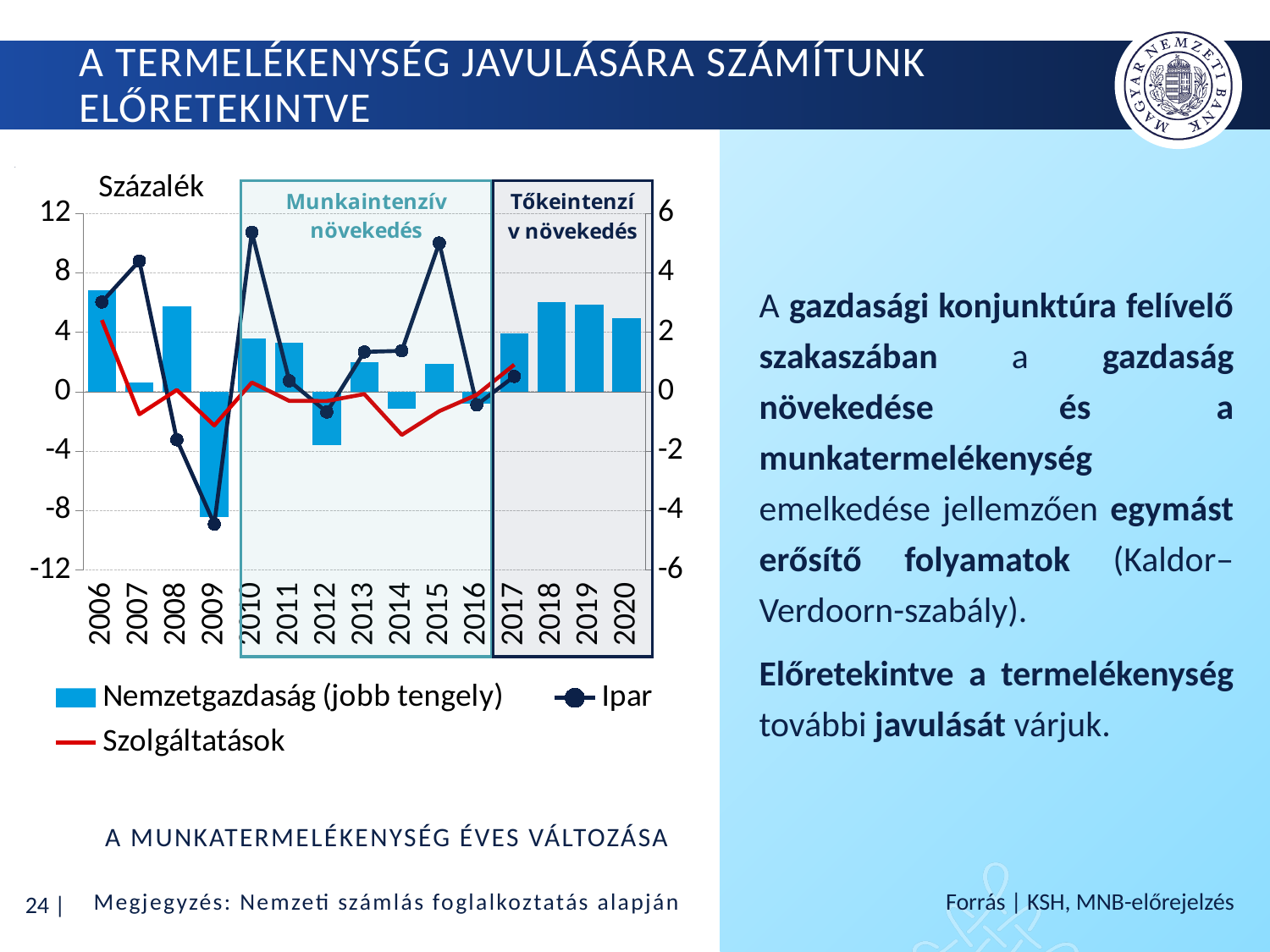
In which year is the Nemzetgazdaság bar lowest? 2009 Which series is plotted on the right axis according to the legend? Nemzetgazdaság How many years are shown on the x axis of the chart? 15 Which is larger, the Nemzetgazdaság bar for 2017 or for 2018? 2018 Do the Nemzetgazdaság bars rise or fall from 2018 to 2020? fall Is the Nemzetgazdaság value for 2012 greater or less than 0? less In which year does the Ipar line reach its lowest value? 2009 Which is larger, the Ipar value for 2010 or the Ipar value for 2012? 2010 What kind of chart is shown on the slide? A combination bar and line chart Is the Ipar value for 2009 greater or less than -4? less Is the Ipar value for 2007 greater or less than 4? greater How many series does the chart legend list? 3